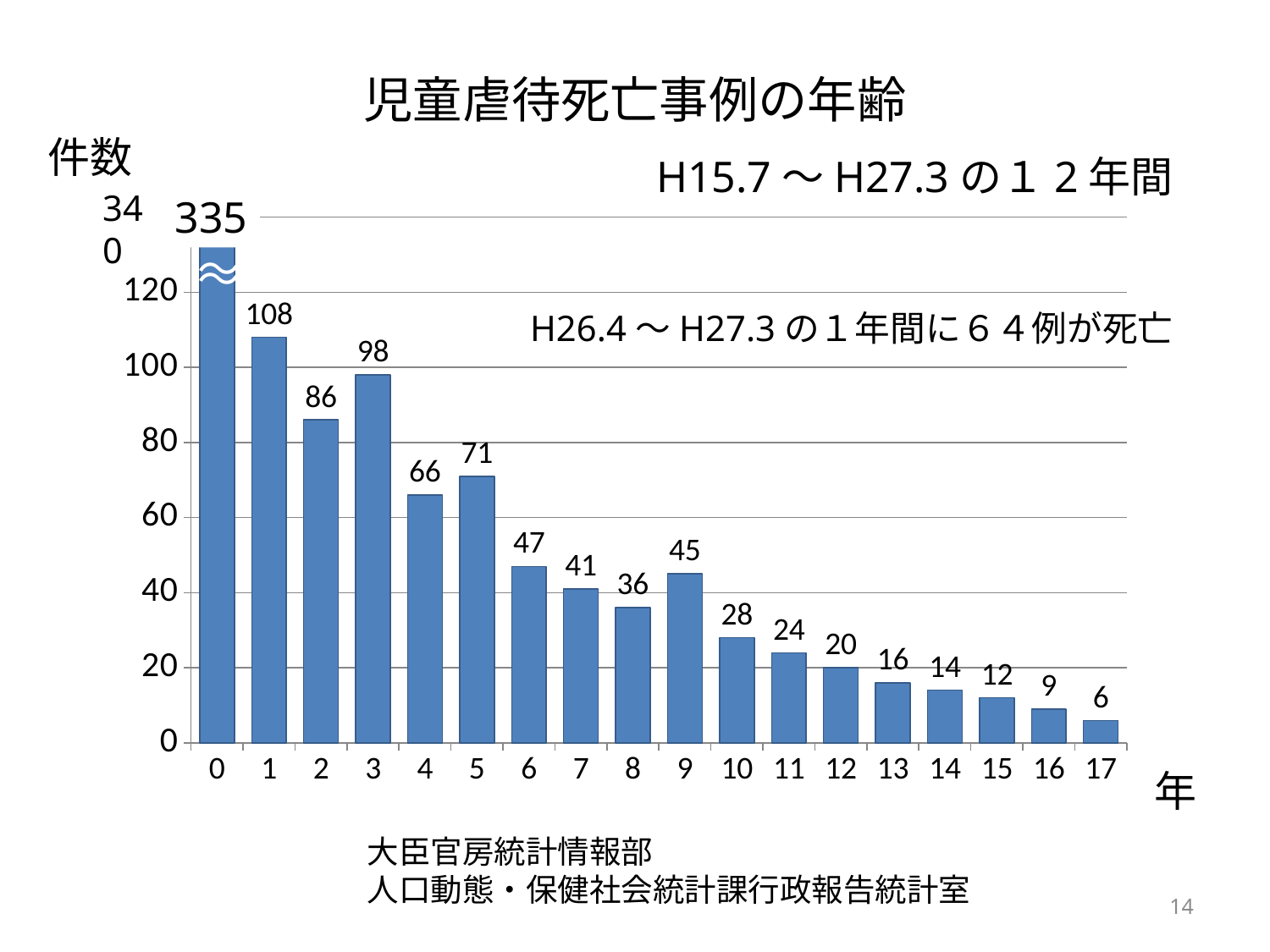
How many age categories are shown on the x axis? 18 What is the value for age 5? 71 What is the value for age 0? 335 Which age has the lowest value? 17 Do the values generally rise or fall from age 9 to age 17? fall What is the value for age 17? 6 What kind of chart is this? bar chart What is the value for age 9? 45 Which is larger, the value for age 4 or the value for age 5? age 5 What is the title of the chart? 児童虐待死亡事例の年齢 What is the difference between the values for age 1 and age 2? 22 Which age has the highest value? 0